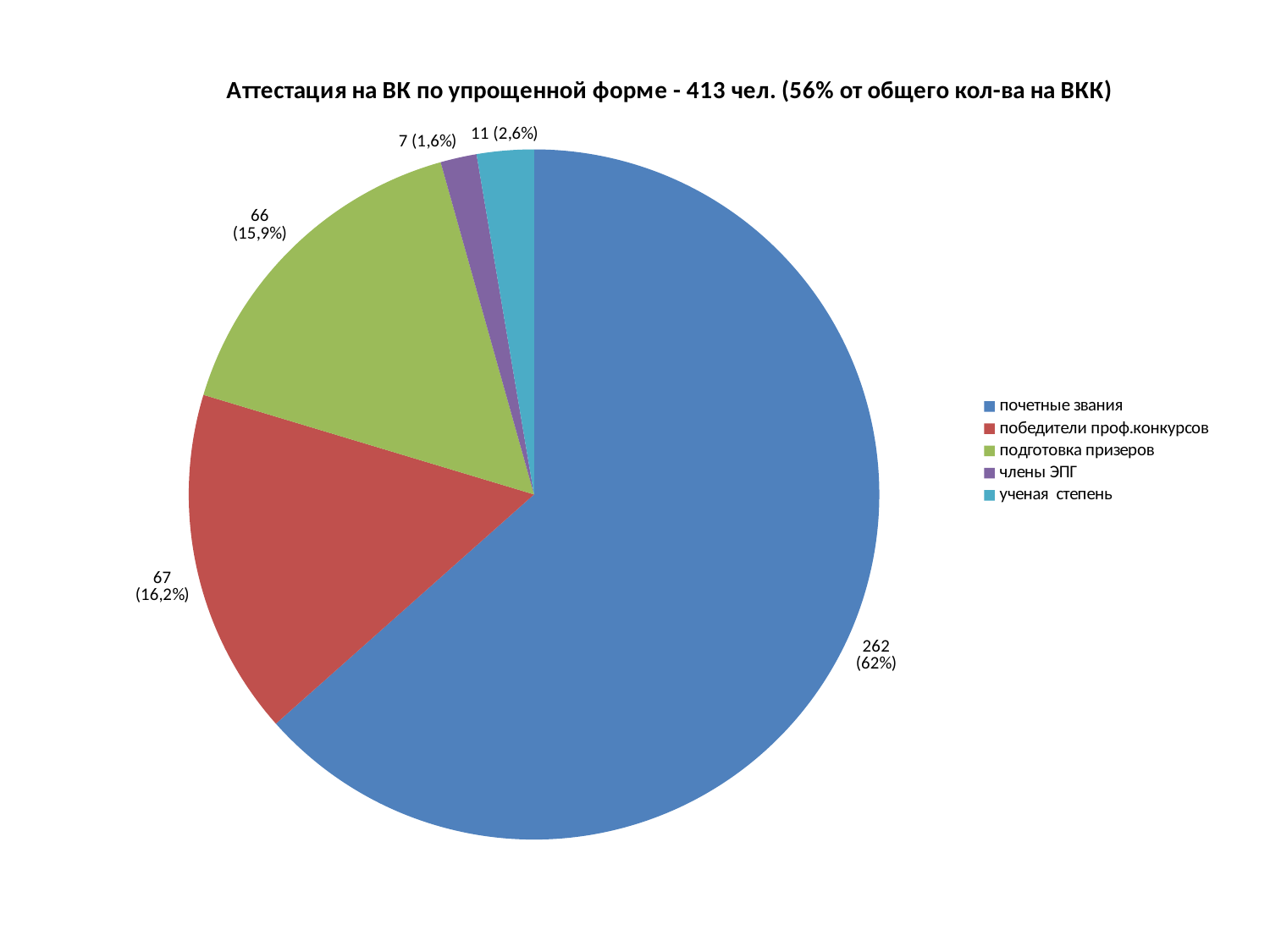
Which category has the smallest slice? члены ЭПГ What is the value for члены ЭПГ? 7 How many slices does the pie chart have? 5 What is the difference between the values for почетные звания and победители проф.конкурсов? 195 How many entries does the legend list? 5 Which is larger, the value for ученая степень or the value for члены ЭПГ? ученая степень What share of the pie does подготовка призеров represent? 15,9% What kind of chart is shown on the slide? pie chart What is the value for почетные звания? 262 What is the value for победители проф.конкурсов? 67 Which category has the largest slice? почетные звания What is the value for ученая степень? 11